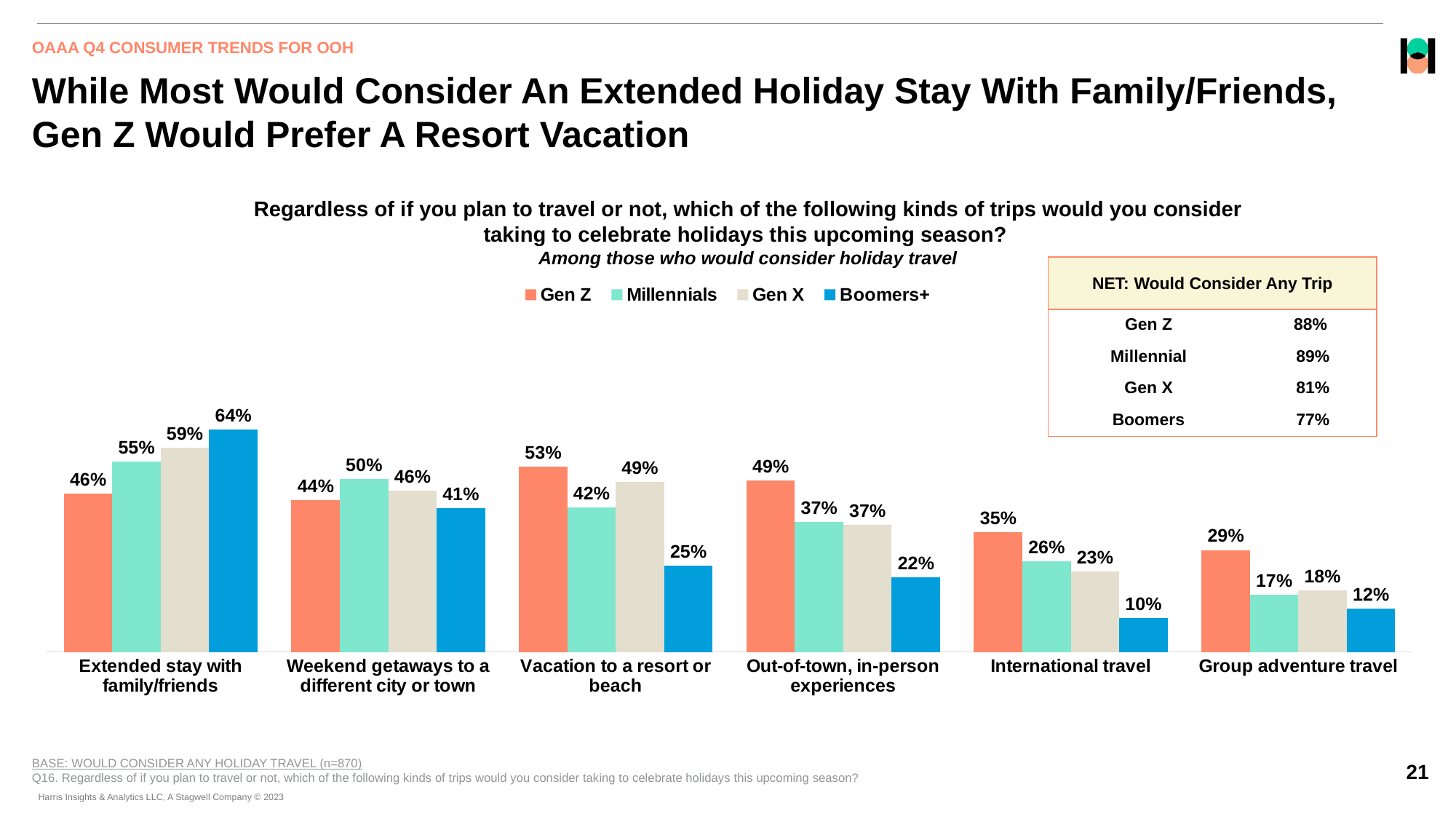
Which trip type has the lowest value for Boomers+? International travel What percentage of Millennials would consider weekend getaways to a different city or town? 50% Which generation has the highest NET: Would Consider Any Trip value in the table? Millennial What is the difference between the Gen Z and Boomers+ values for vacation to a resort or beach? 28 percentage points What kind of chart is shown on the slide? Bar chart How many series does the chart legend list? 4 How many trip categories are shown on the x axis of the chart? 6 Which colour represents Boomers+ in the chart legend? Blue What percentage of Boomers+ would consider an extended stay with family/friends? 64% What percentage of Gen Z would consider a vacation to a resort or beach? 53% For out-of-town, in-person experiences, which is larger: the Gen Z value or the Gen X value? Gen Z Which trip type has the highest value for Gen Z? Vacation to a resort or beach